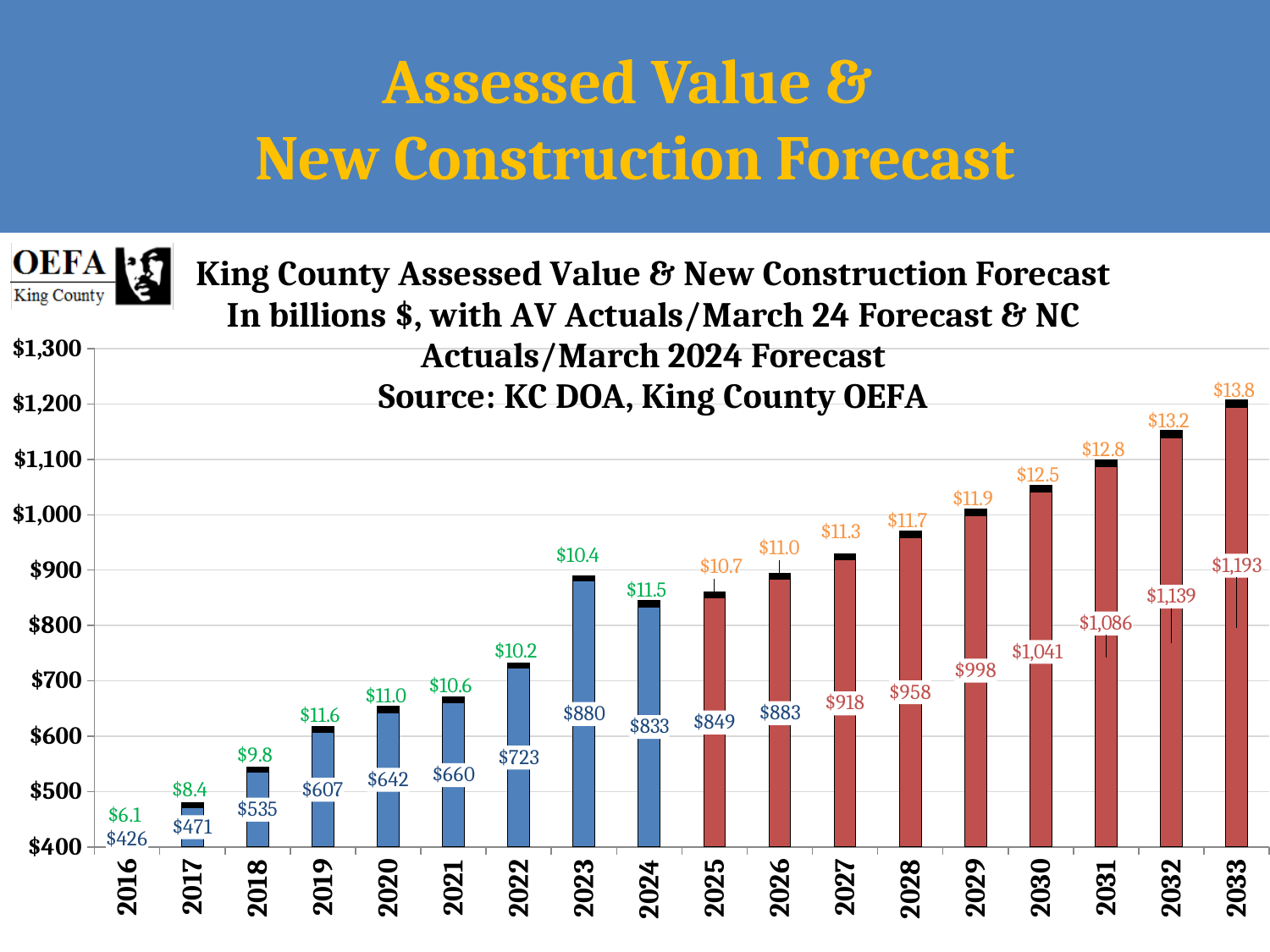
Which year has the lowest new construction value? 2016 Which year has the highest assessed value? 2033 What is the new construction value shown for 2033? $13.8 What is the source cited in the chart title? KC DOA, King County OEFA How many years are shown on the x axis? 18 What is the assessed value shown for 2030? $1,041 Do the assessed values generally rise or fall from 2025 to 2033? Rise What is the difference between the new construction value for 2033 and for 2032? $0.6 What kind of chart is shown on the slide? Bar chart What is the assessed value shown for 2023? $880 Which is larger, the new construction value for 2019 or for 2020? 2019 What is the difference between the assessed value for 2024 and for 2023? $47